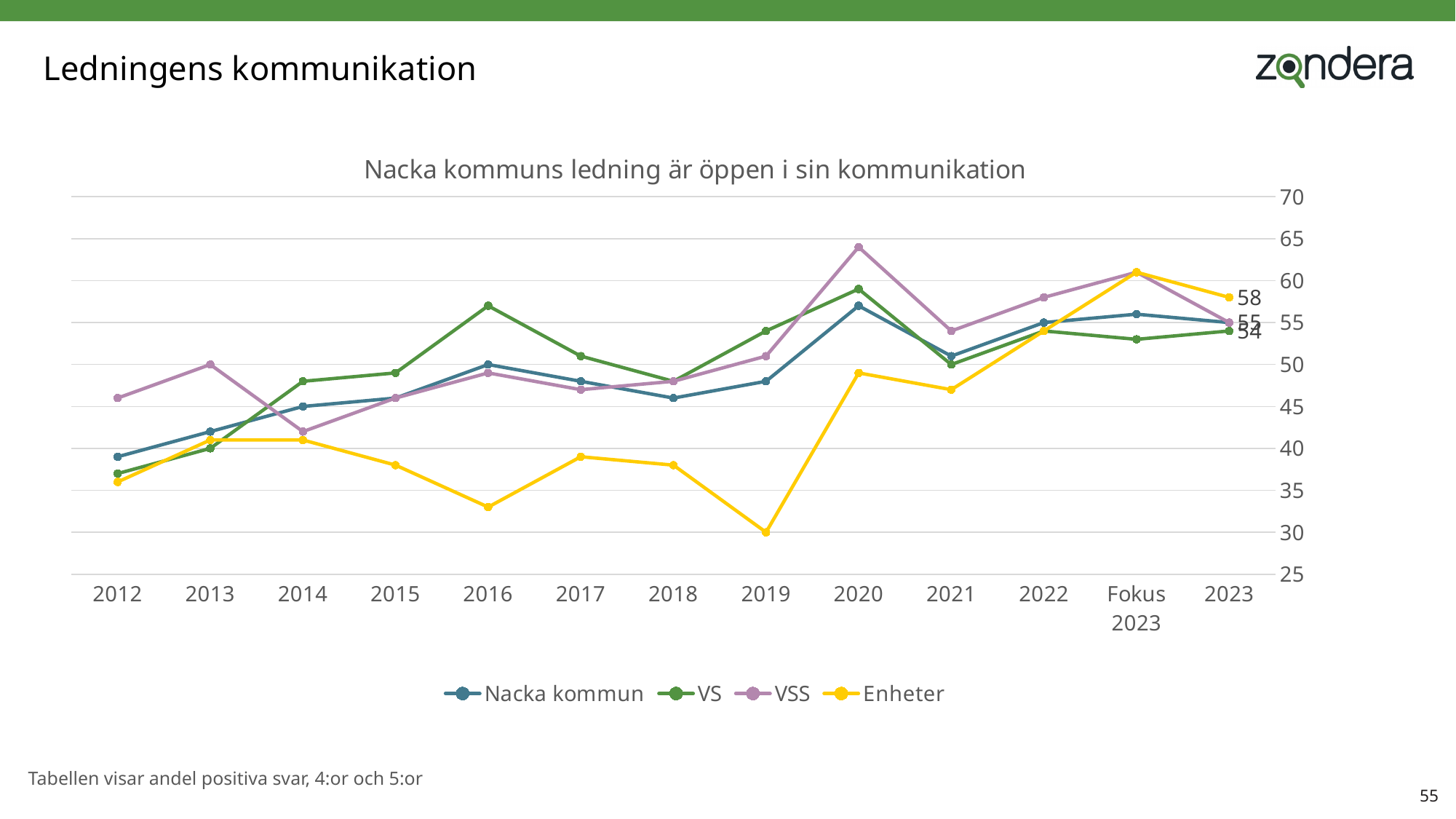
Is the value for Enheter in 2019 greater or less than 35? less What is the title of the chart? Nacka kommuns ledning är öppen i sin kommunikation What kind of chart is shown on the slide? line chart Is the value for VS in 2016 greater or less than 55? greater Is the value for VSS in 2020 greater or less than 60? greater In 2013, which is larger: the value for VSS or the value for Enheter? VSS How many series does the legend list? 4 Which series has the lowest value in 2019? Enheter Which series has the highest value in 2020? VSS Does the Nacka kommun series rise or fall overall from 2012 to 2023? rise How many points are there along the x axis? 13 What is the value for Enheter in 2023? 58